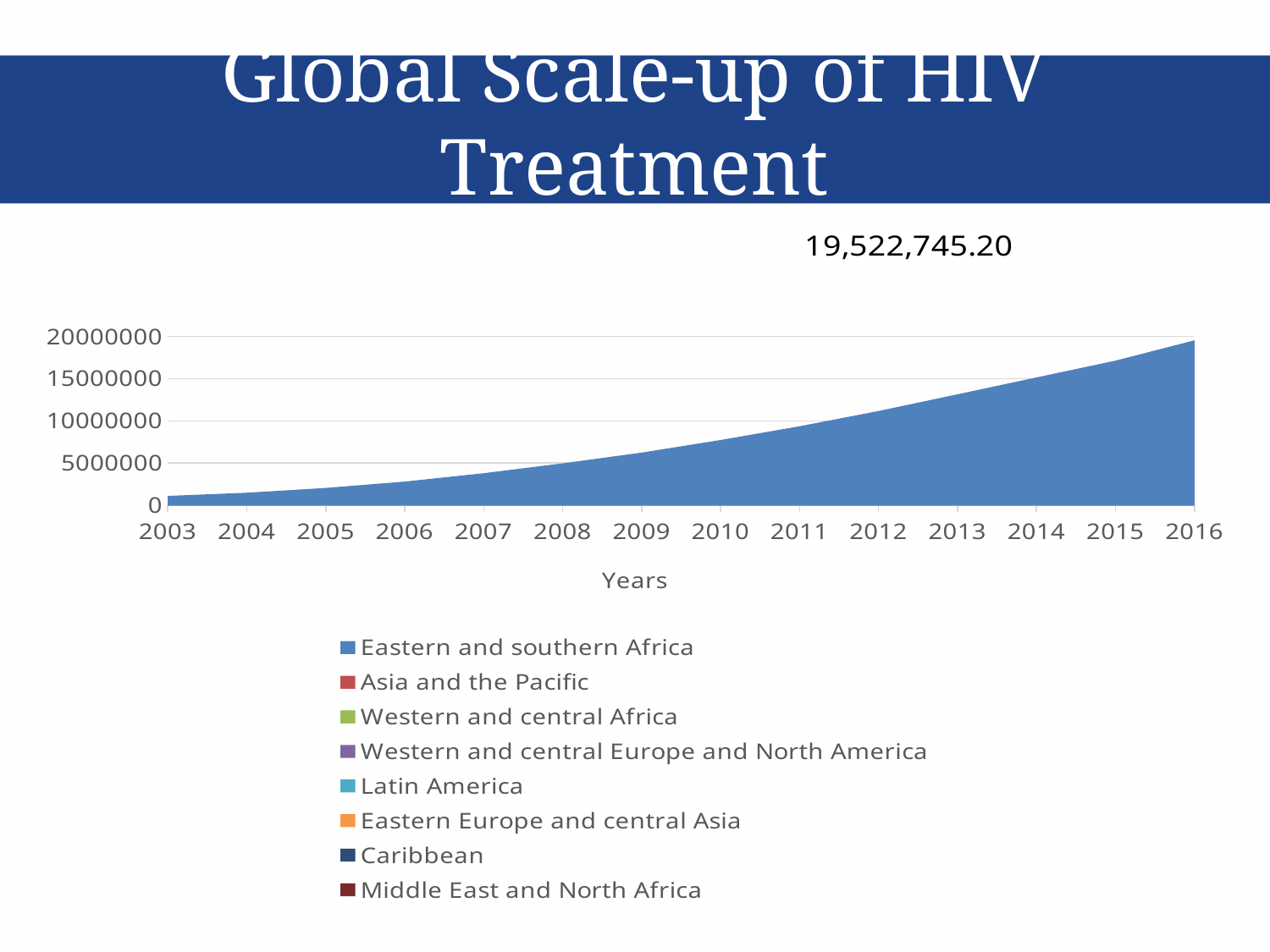
Which year has the lowest plotted value? 2003 Is the value for 2010 greater or less than 10000000? less What is the title of the x axis? Years How many series does the chart's legend list? 8 What is the first series listed in the legend? Eastern and southern Africa Which year has the larger value, 2008 or 2015? 2015 How many years are shown along the x axis of the chart? 14 What kind of chart is shown on the slide? Area chart Is the value for 2016 greater or less than 15000000? greater Which year has the highest plotted value? 2016 Do the plotted values rise or fall from 2003 to 2016? Rise Is the value for 2003 greater or less than 5000000? less